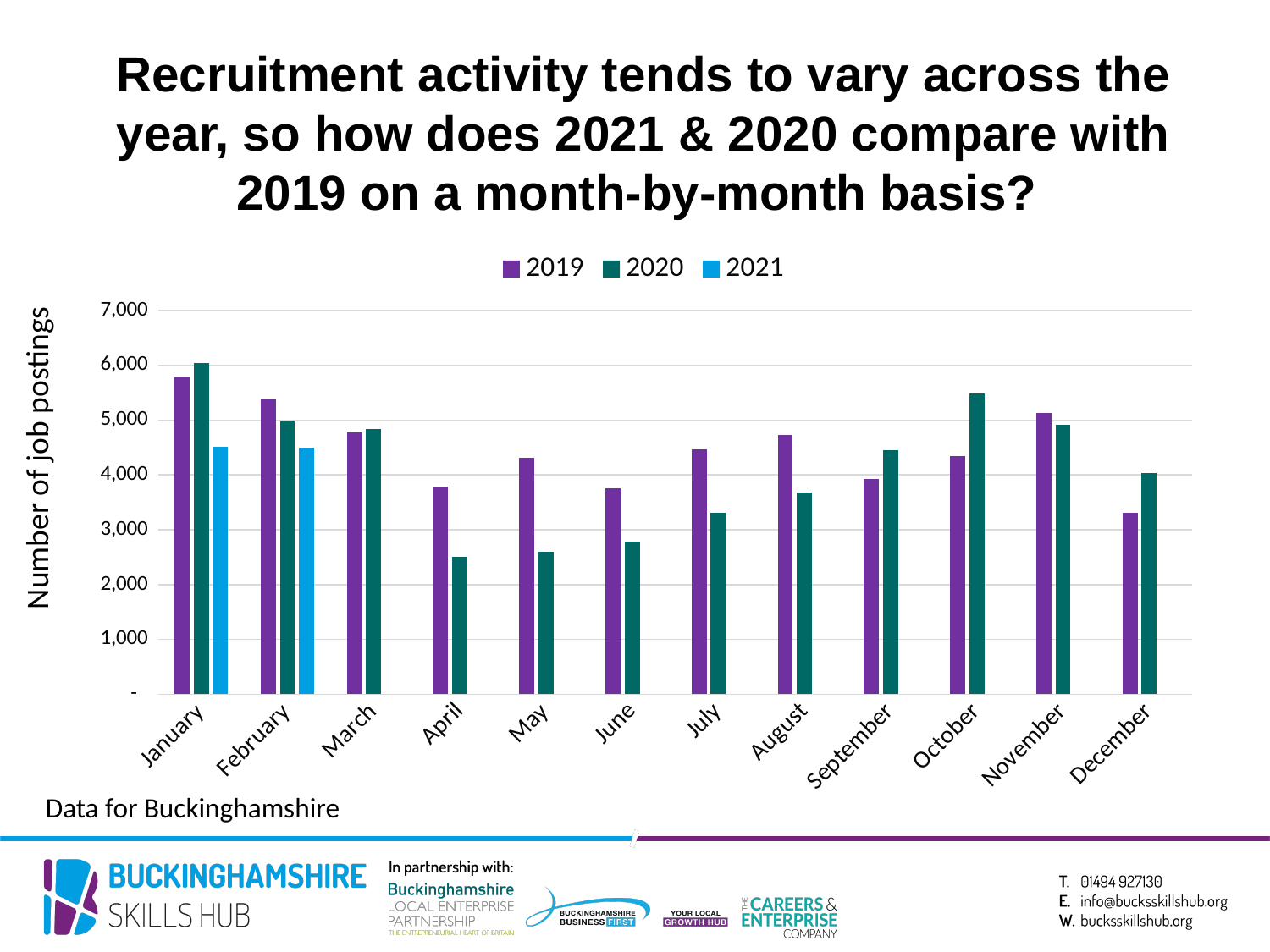
Is the value for 2020 in October greater or less than 5,000? greater In October, which year had more job postings, 2019 or 2020? 2020 What kind of chart is shown on the slide? Bar chart Which month has the lowest number of job postings for 2020? April Which month has the highest number of job postings for 2019? January Is the value for 2020 in April greater or less than 3,000? less In April, which year had more job postings, 2019 or 2020? 2019 Which month has the lowest number of job postings for 2019? December How many months are shown along the x axis? 12 Which month has the highest number of job postings for 2020? January How many series does the legend list? 3 Which months have a bar for 2021? January and February